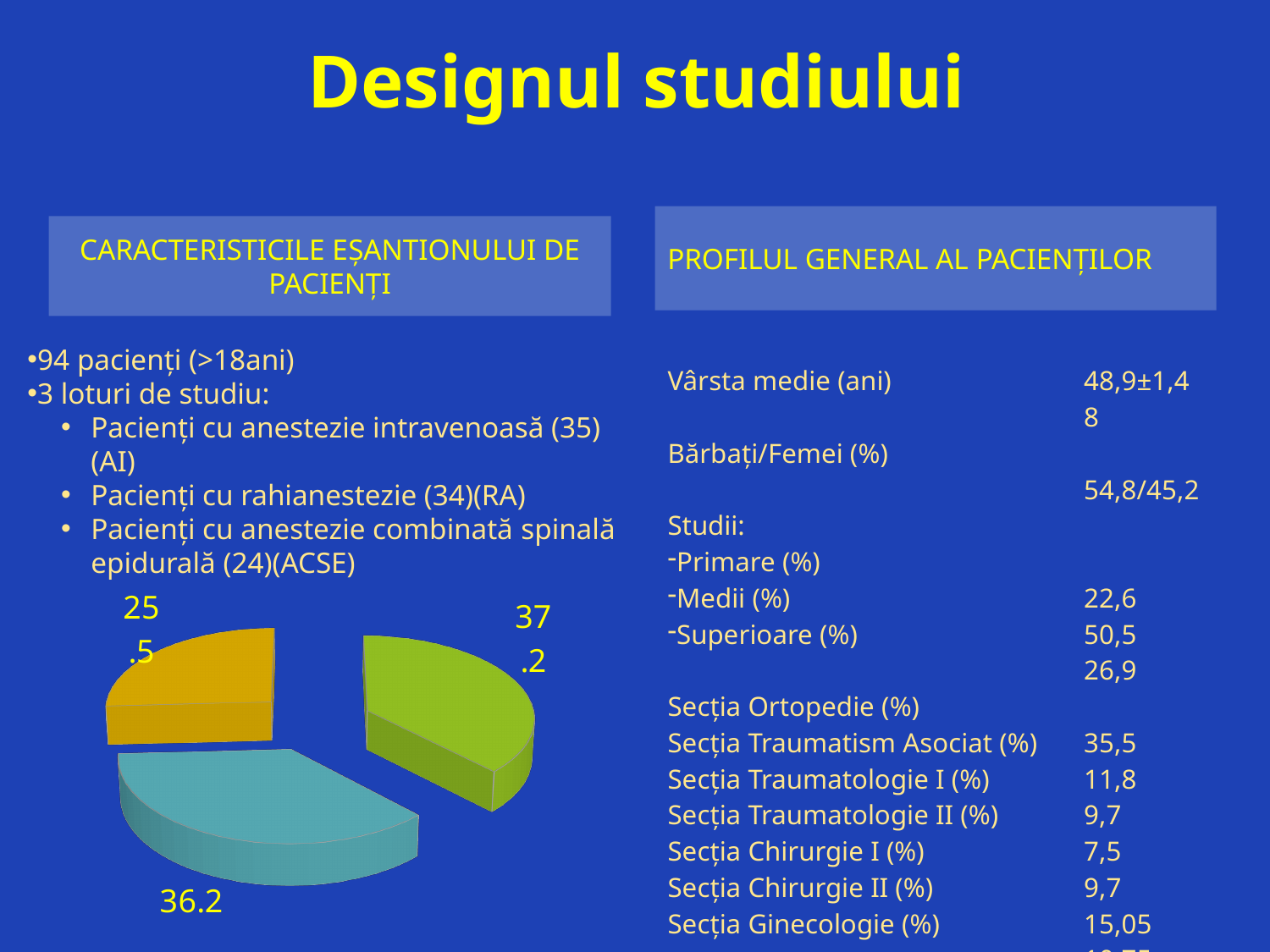
Which is larger in the pie chart, the green slice or the blue slice? the green slice How many slices does the pie chart have? 3 Which slice of the pie chart has the largest value? the green slice (37.2) What value is labelled on the orange slice of the pie chart? 25.5 What is the difference between the green slice value and the blue slice value in the pie chart? 1.0 Does the pie chart include a legend? No What value is labelled on the blue slice of the pie chart? 36.2 What kind of chart is shown on the slide? pie chart What is the sum of the three values labelled on the pie chart? 98.9 What is the difference between the largest and smallest slice values in the pie chart? 11.7 What value is labelled on the green slice of the pie chart? 37.2 Which slice of the pie chart has the smallest value? the orange slice (25.5)